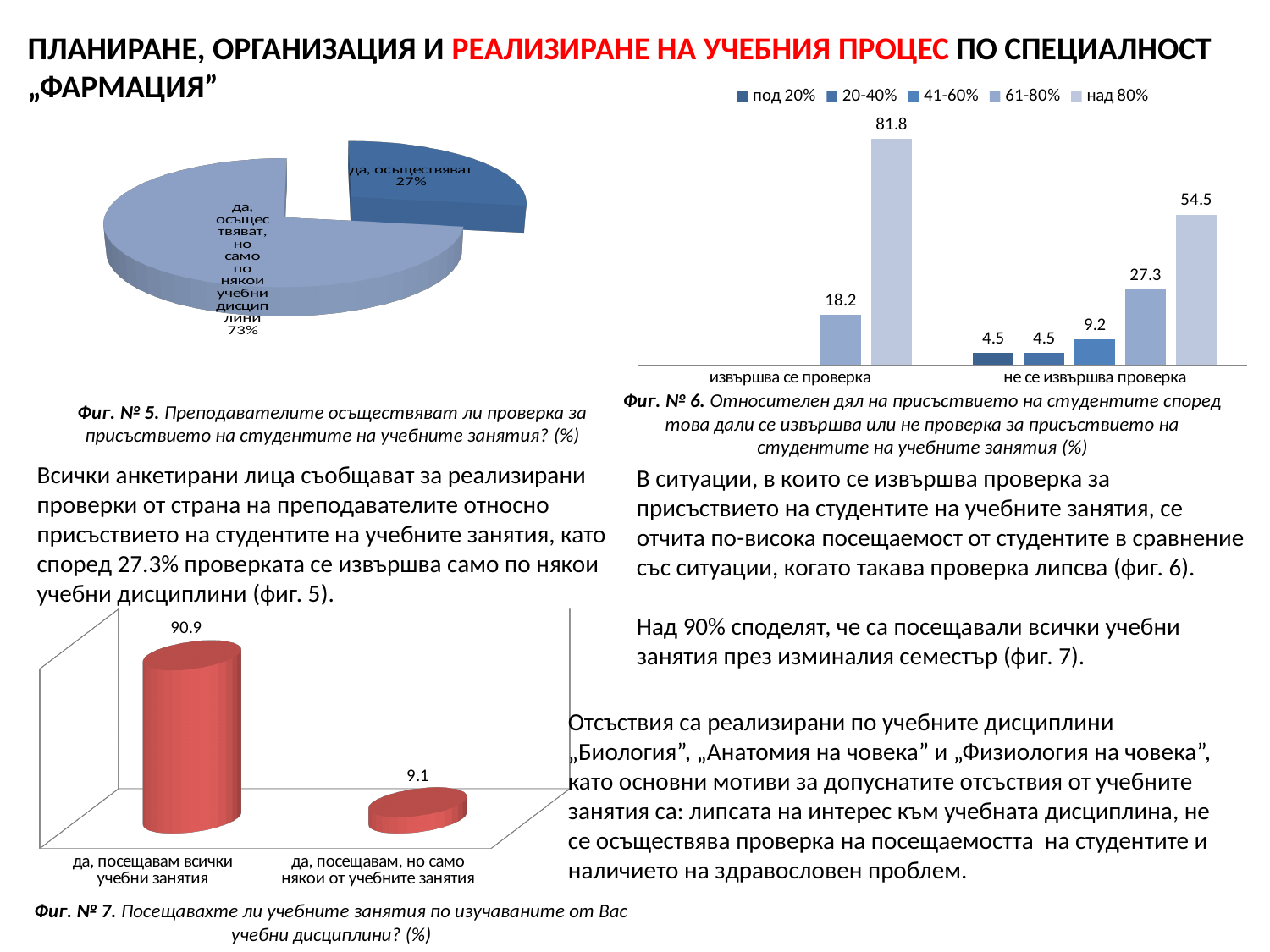
In the bar chart (Фиг. № 7), what is the value for "да, посещавам всички учебни занятия"? 90.9 In the pie chart (Фиг. № 5), how many slices are there? 2 In the bar chart (Фиг. № 6), what is the value of the "61-80%" series for "не се извършва проверка"? 27.3 In the bar chart (Фиг. № 6), which category has the higher "над 80%" value: "извършва се проверка" or "не се извършва проверка"? извършва се проверка In the bar chart (Фиг. № 6), what is the value of the "над 80%" series for "извършва се проверка"? 81.8 In the bar chart (Фиг. № 6), what is the value of the "над 80%" series for "не се извършва проверка"? 54.5 In the bar chart (Фиг. № 7), what is the difference between the two bars? 81.8 In the pie chart (Фиг. № 5), what share is labelled "да, осъществяват, но само по някои учебни дисциплини"? 73% In the bar chart (Фиг. № 6), how many series does the legend list? 5 What kind of chart is Фиг. № 7? bar chart In the pie chart (Фиг. № 5), what share is labelled "да, осъществяват"? 27% In the bar chart (Фиг. № 6), what is the difference between the "над 80%" values for "извършва се проверка" and "не се извършва проверка"? 27.3